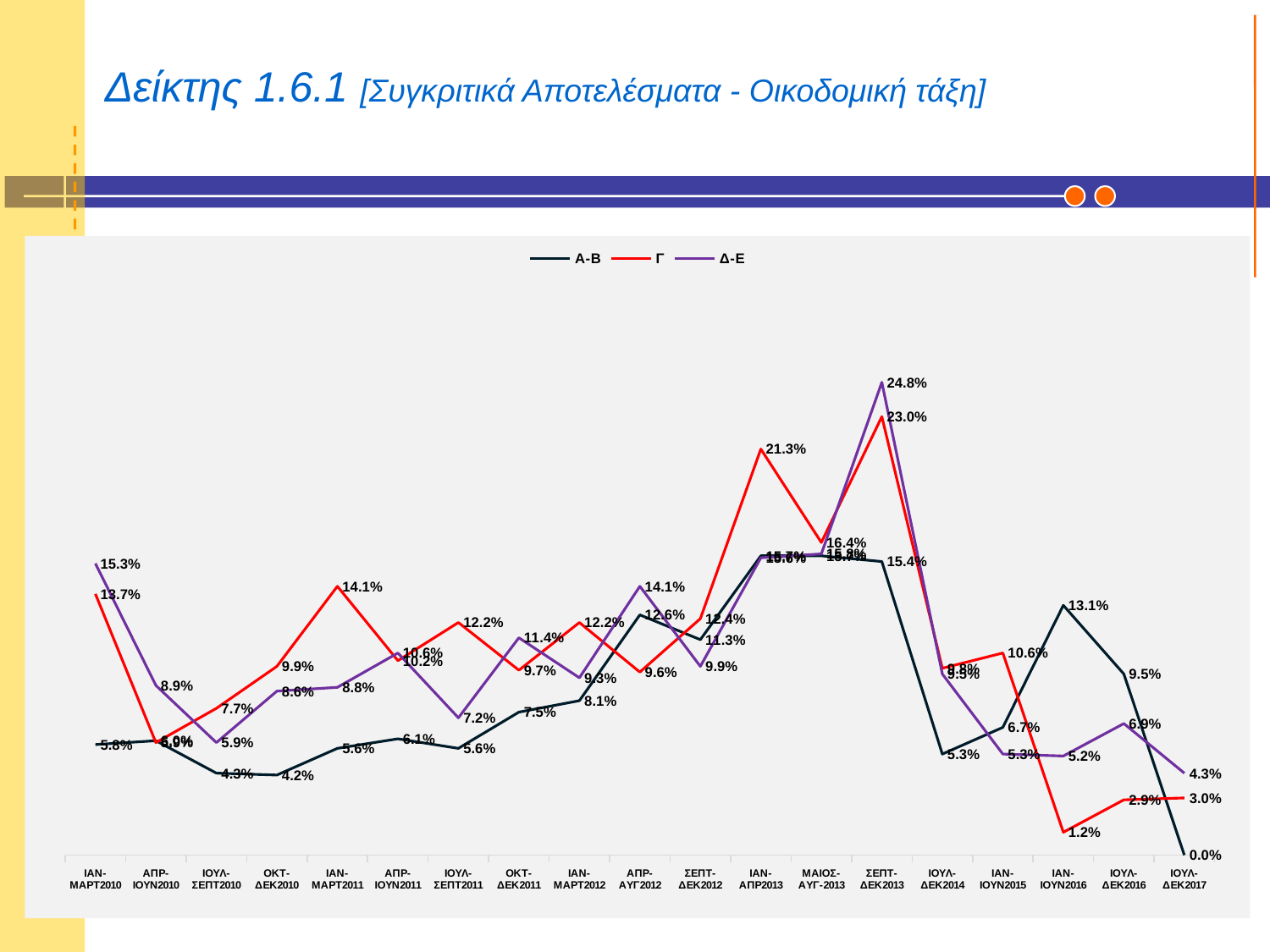
How many series does the legend list? 3 Does the Α-Β series rise or fall from ΙΑΝ-ΙΟΥΝ2016 to ΙΟΥΛ-ΔΕΚ2017? Fall How many time periods are shown on the x axis? 19 What is the value of the Δ-Ε series at ΣΕΠΤ-ΔΕΚ2013? 24.8% Which series has the lowest value at ΙΑΝ-ΙΟΥΝ2016? Γ Which series has the highest value at ΣΕΠΤ-ΔΕΚ2013? Δ-Ε What is the value of the Γ series at ΙΑΝ-ΑΠΡ2013? 21.3% Which is larger at ΙΑΝ-ΜΑΡΤ2010: the Δ-Ε value or the Γ value? Δ-Ε What kind of chart is shown on the slide? Line chart What is the difference between the Γ and Α-Β values at ΣΕΠΤ-ΔΕΚ2013? 7.6% What is the value of the Α-Β series at ΙΟΥΛ-ΔΕΚ2017? 0.0% What is the value of the Γ series at ΙΑΝ-ΙΟΥΝ2016? 1.2%